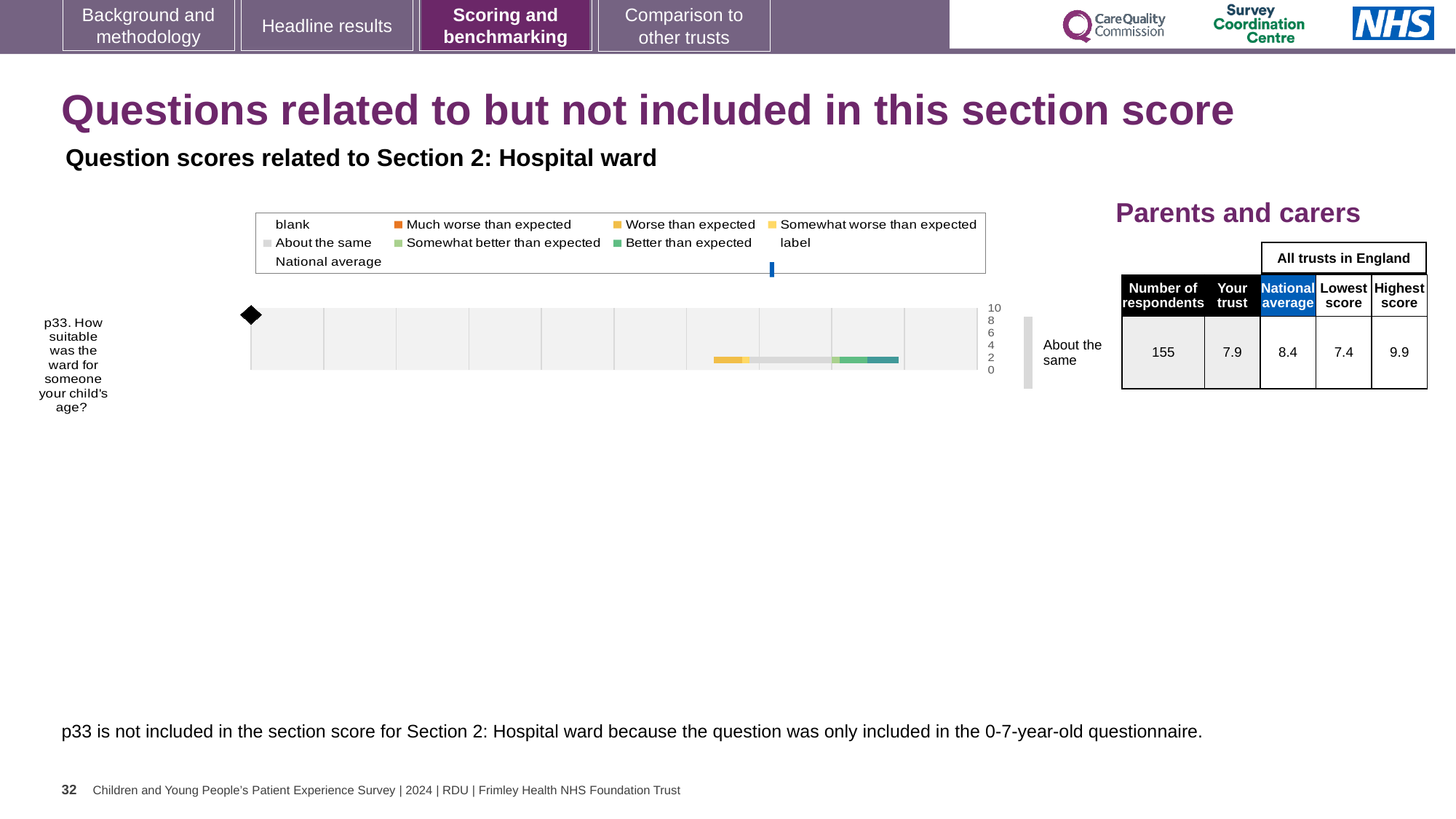
Which question is plotted in the chart? p33. How suitable was the ward for someone your child's age? What kind of chart is shown on the slide? bar chart What colour does the legend use for 'Much worse than expected'? orange How many entries does the chart legend list? 9 How many questions (categories) are plotted in the chart? 1 What is the lowest tick value shown on the chart axis? 0 What benchmark category label is shown to the right of the bar for p33? About the same